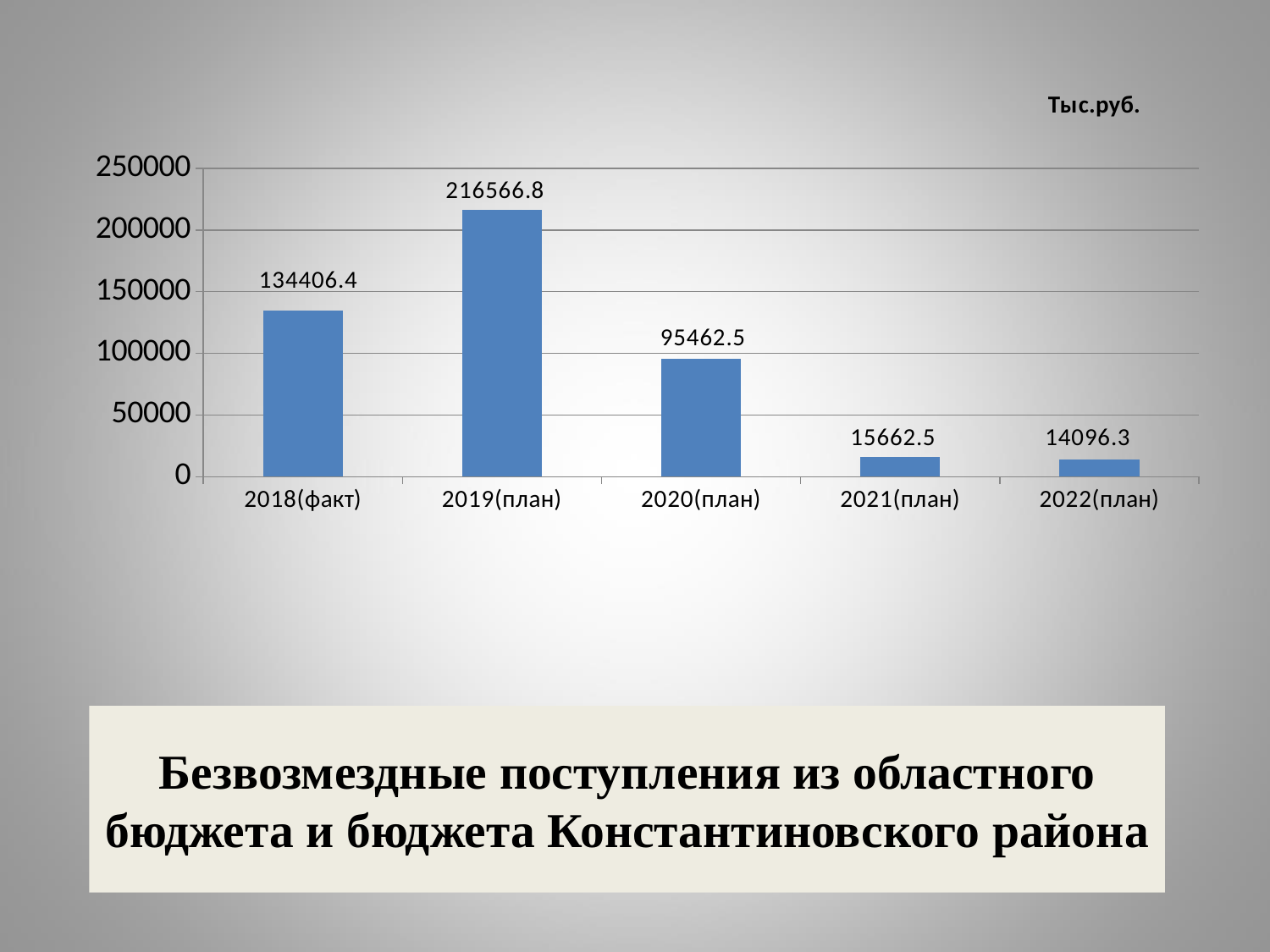
What unit is indicated in the top right corner of the chart? Тыс.руб. What kind of chart is shown on the slide? bar chart Which is larger, the value for 2018(факт) or the value for 2020(план)? 2018(факт) Which category has the highest value? 2019(план) What is the difference between the values for 2019(план) and 2018(факт)? 82160.4 Is the value for 2020(план) greater or less than 100000? less How many categories are shown on the x axis? 5 Which category has the lowest value? 2022(план) What is the value for 2022(план)? 14096.3 What is the value for 2019(план)? 216566.8 What is the value for 2018(факт)? 134406.4 What is the difference between the values for 2021(план) and 2022(план)? 1566.2